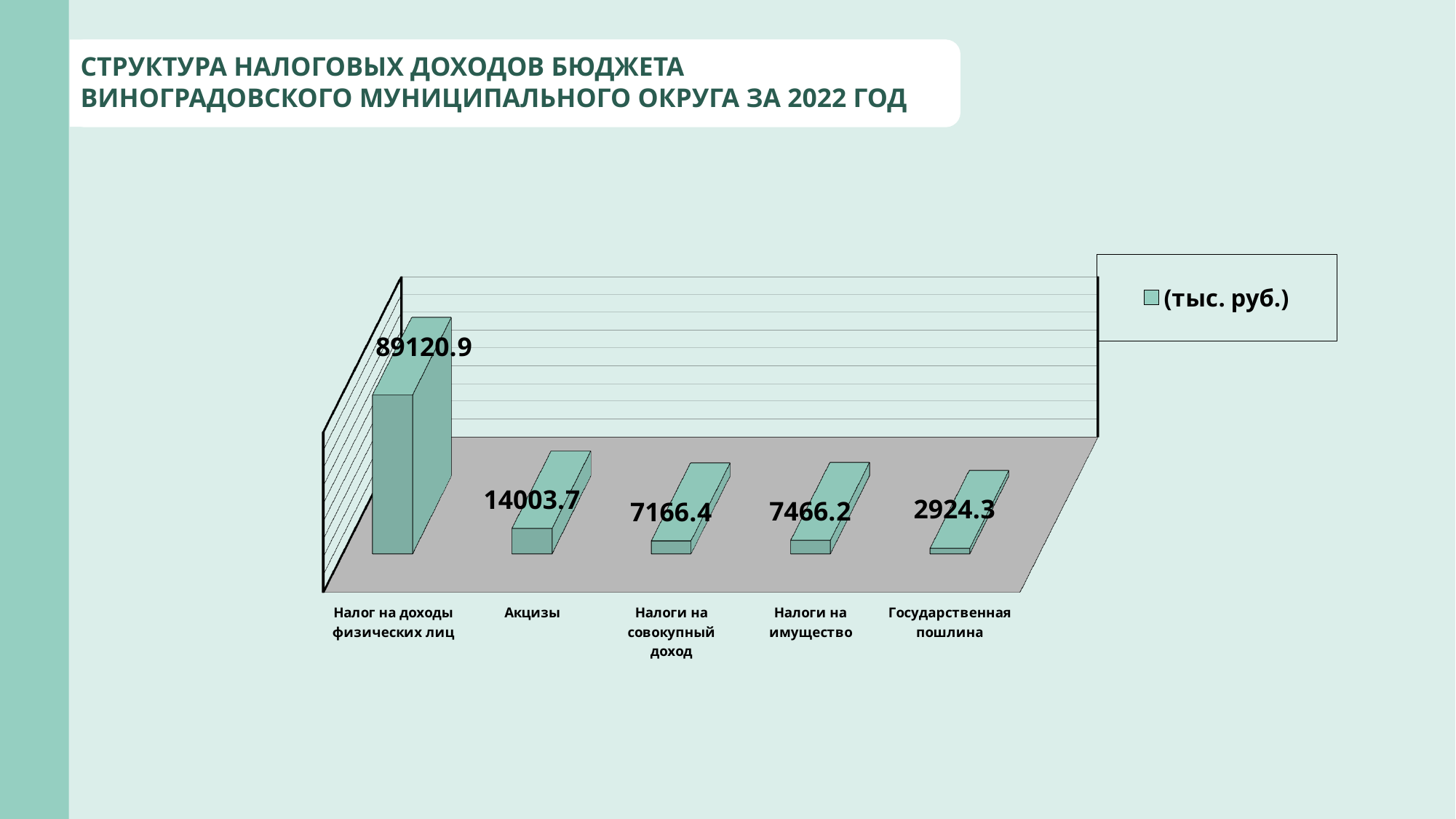
Which category has the highest value? Налог на доходы физических лиц What is the difference between the values for Налог на доходы физических лиц and Акцизы? 75117.2 How many categories are shown in the chart? 5 What is the value for Налог на доходы физических лиц? 89120.9 What is the value for Акцизы? 14003.7 Which is larger, the value for Налоги на имущество or the value for Налоги на совокупный доход? Налоги на имущество What is the value for Налоги на имущество? 7466.2 What is the value for Государственная пошлина? 2924.3 Which category has the lowest value? Государственная пошлина What is the value for Налоги на совокупный доход? 7166.4 What is the legend entry shown for the series? (тыс. руб.) What kind of chart is shown on the slide? Bar chart